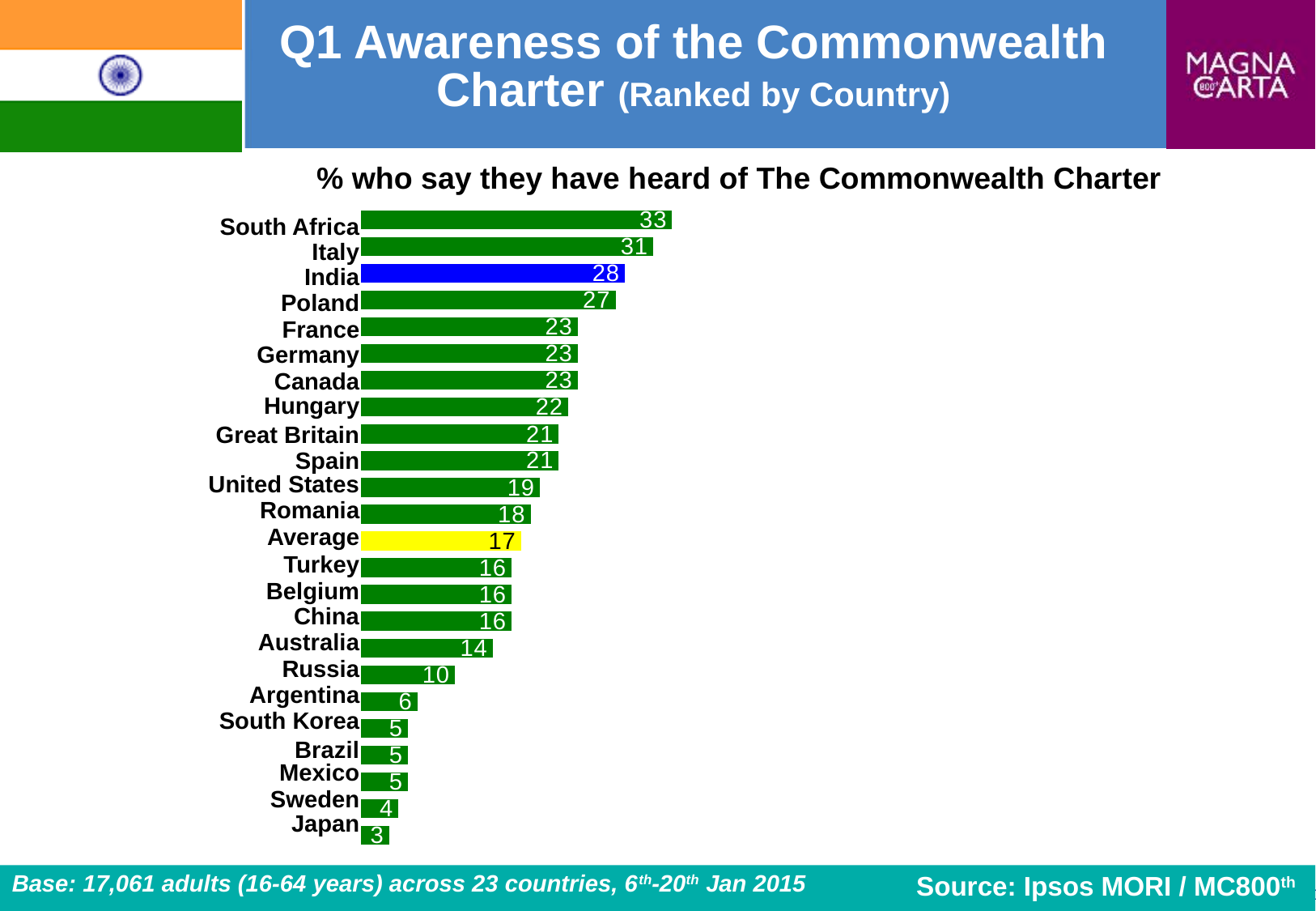
Which has a larger value, Australia or Argentina? Australia What is the value for India? 28 Which country has the highest value? South Africa How many bars are plotted in the chart, including the Average bar? 24 Which has a larger value, Poland or Hungary? Poland What is the difference between the values for India and the Average? 11 What is the value for the Average bar? 17 Which country has the lowest value? Japan What is the difference between the values for South Africa and Italy? 2 What is the value for Russia? 10 What kind of chart is shown on the slide? Bar chart Which bar is highlighted in blue? India